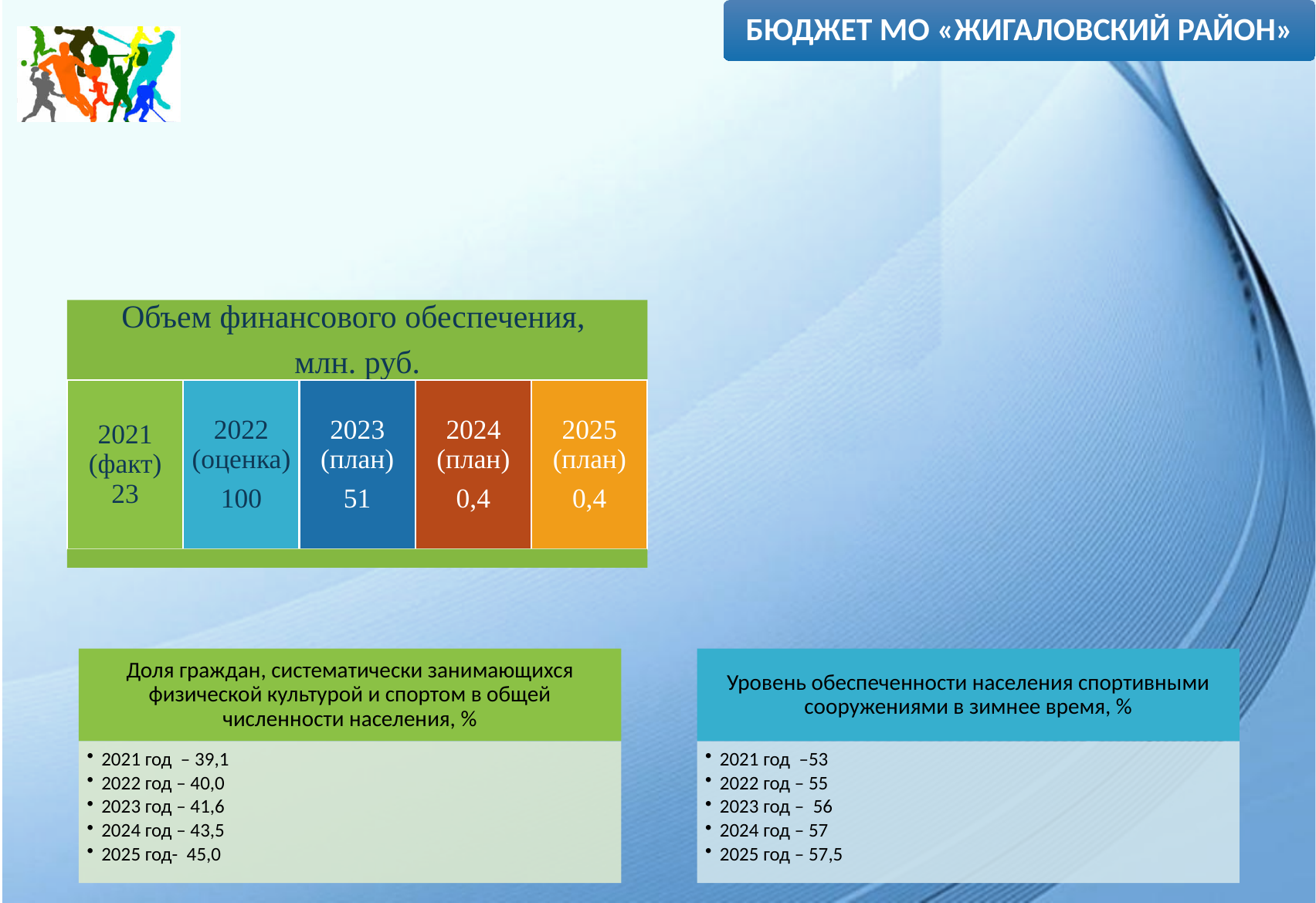
In the 'Объем финансового обеспечения, млн. руб.' graphic, which is larger, the value for 2021 (факт) or 2023 (план)? 2023 (план) In the 'Объем финансового обеспечения, млн. руб.' graphic, what colour is the block for 2024 (план)? Dark orange (brown-red) In the 'Объем финансового обеспечения, млн. руб.' graphic, do the values rise or fall from 2023 (план) to 2025 (план)? fall In the 'Объем финансового обеспечения, млн. руб.' graphic, what is the value for 2022 (оценка)? 100 In the 'Объем финансового обеспечения, млн. руб.' graphic, what is the value for 2021 (факт)? 23 How many years are shown in the 'Объем финансового обеспечения, млн. руб.' graphic? 5 In the 'Объем финансового обеспечения, млн. руб.' graphic, what is the value for 2025 (план)? 0,4 What is the title of the colored block graphic on the left of the slide? Объем финансового обеспечения, млн. руб. In the 'Объем финансового обеспечения, млн. руб.' graphic, what is the difference between the values for 2023 (план) and 2021 (факт)? 28 In the 'Объем финансового обеспечения, млн. руб.' graphic, what is the value for 2023 (план)? 51 In the 'Объем финансового обеспечения, млн. руб.' graphic, which year has the highest value? 2022 (оценка) In the 'Объем финансового обеспечения, млн. руб.' graphic, what is the difference between the values for 2022 (оценка) and 2023 (план)? 49